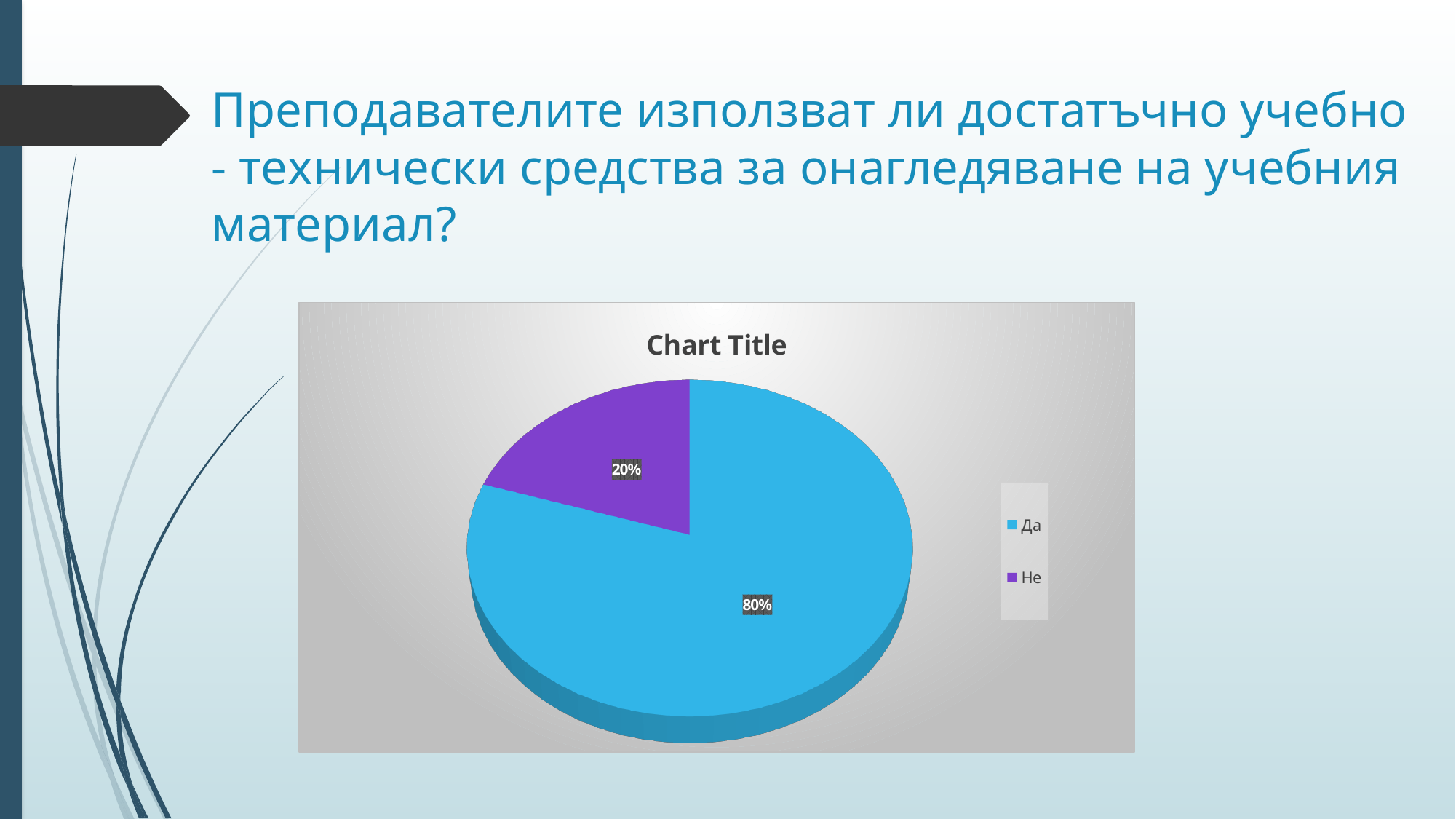
Which slice is larger, "Да" or "Не"? Да How many entries does the legend list? 2 What is the title shown on the chart? Chart Title Which category has the largest slice of the pie? Да What share of the pie does the "Да" slice represent? 80% Which category has the smallest slice of the pie? Не What share of the pie does the "Не" slice represent? 20% What is the difference in percentage points between the "Да" and "Не" slices? 60% What kind of chart is shown on the slide? pie chart How many slices does the pie chart have? 2 What colour is the "Не" slice? purple